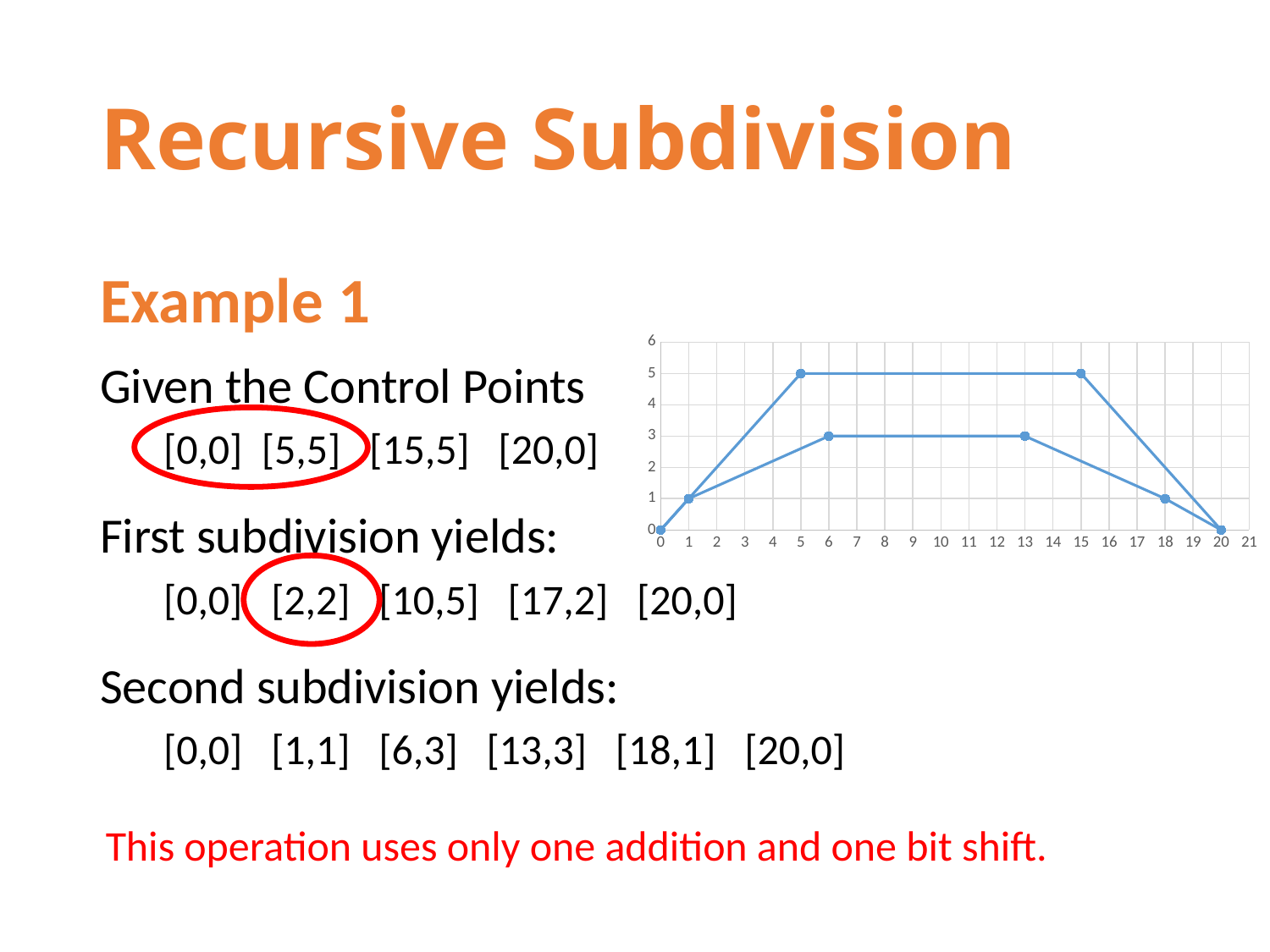
What is the y value of the lower line at x = 6? 3 Between x = 15 and x = 20, does the upper line rise or fall? fall What is the highest y value reached by any point on the chart? 5 How many data points does the upper (outer) line have? 4 How many data points does the lower (inner) line have? 6 What kind of chart is shown on the slide? line chart At x = 13, is the value of the lower line greater or less than 4? less What is the y value of the lower line at x = 18? 1 What is the y value of the upper line at x = 5? 5 At x = 15, which line has the higher y value, the upper line or the lower line? the upper line What is the largest tick value shown on the x axis? 21 How many lines are plotted on the chart? 2